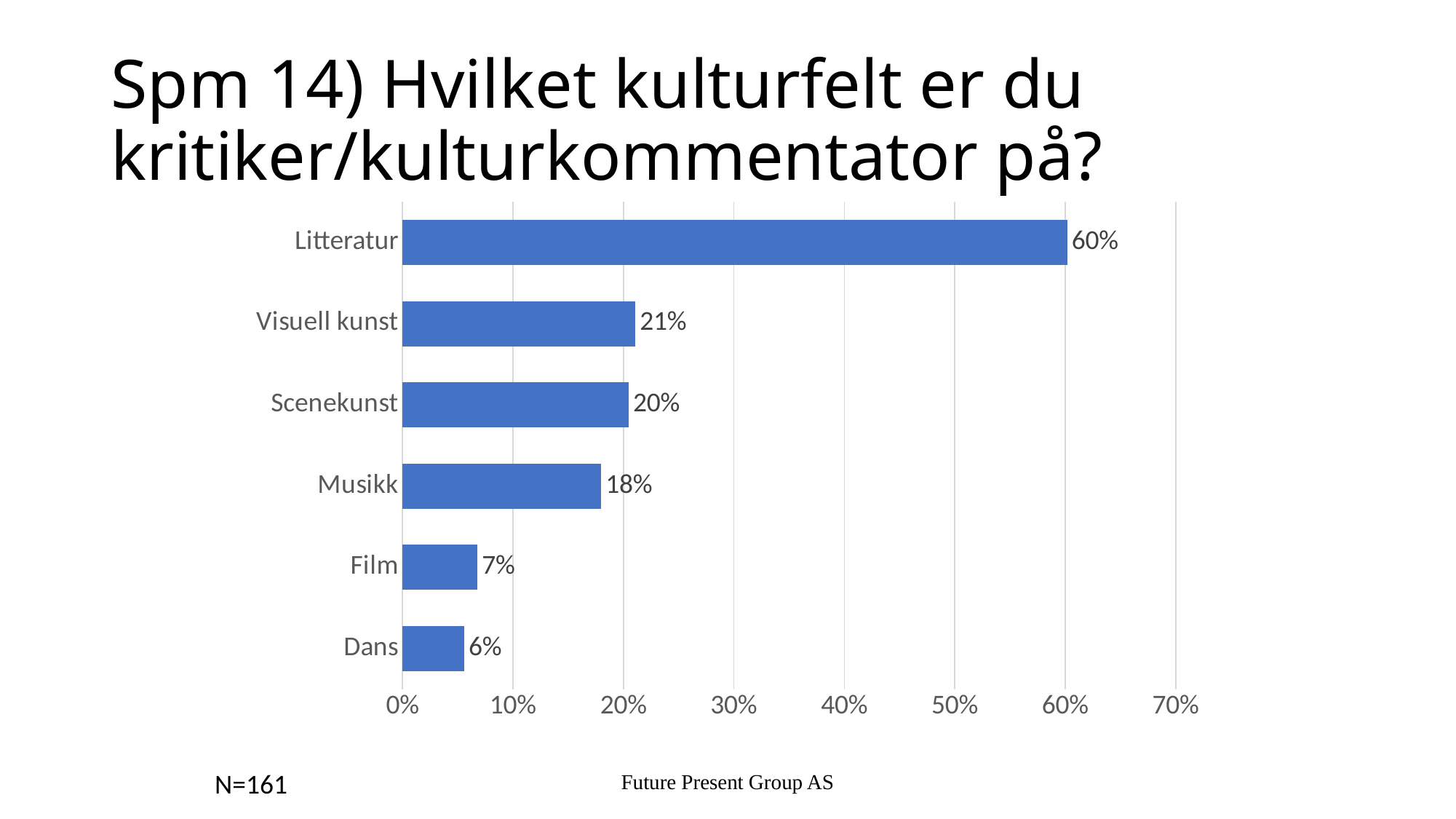
How many categories are shown in the chart? 6 What is the value for Litteratur? 60% Which category has the lowest value? Dans What is the value for Musikk? 18% What kind of chart is shown on the slide? bar chart Which is larger, the value for Scenekunst or the value for Film? Scenekunst What is the value for Dans? 6% Which category has the highest value? Litteratur What is the difference between the values for Musikk and Film? 11% Is the value for Visuell kunst greater or less than 30%? less What is the sample size (N) stated on the slide? N=161 What is the difference between the values for Litteratur and Visuell kunst? 39%